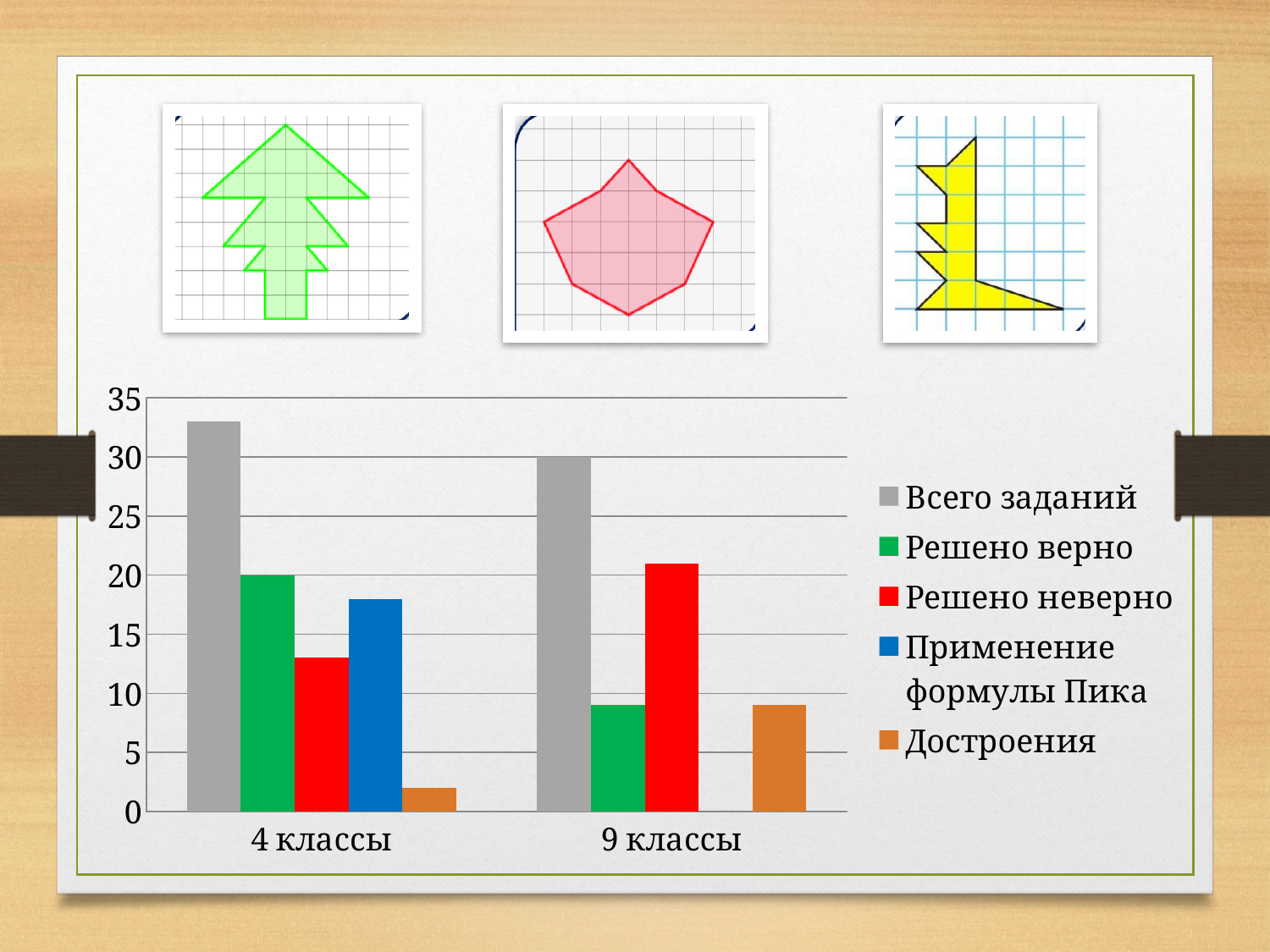
Is the value of Достроения for 4 классы greater or less than 5? less How many categories are shown on the x axis of the chart? 2 How many series does the chart's legend list? 5 What is the value of Решено верно for 4 классы? 20 Is the value of Всего заданий for 4 классы greater or less than 30? greater What kind of chart is shown on the slide? bar chart What colour represents Применение формулы Пика in the legend? blue What is the value of Всего заданий for 9 классы? 30 Which category has the larger value for Решено верно, 4 классы or 9 классы? 4 классы Is the value of Решено неверно for 9 классы greater or less than 20? greater Which series has the highest value for 4 классы? Всего заданий Which series has the lowest value for 4 классы? Достроения